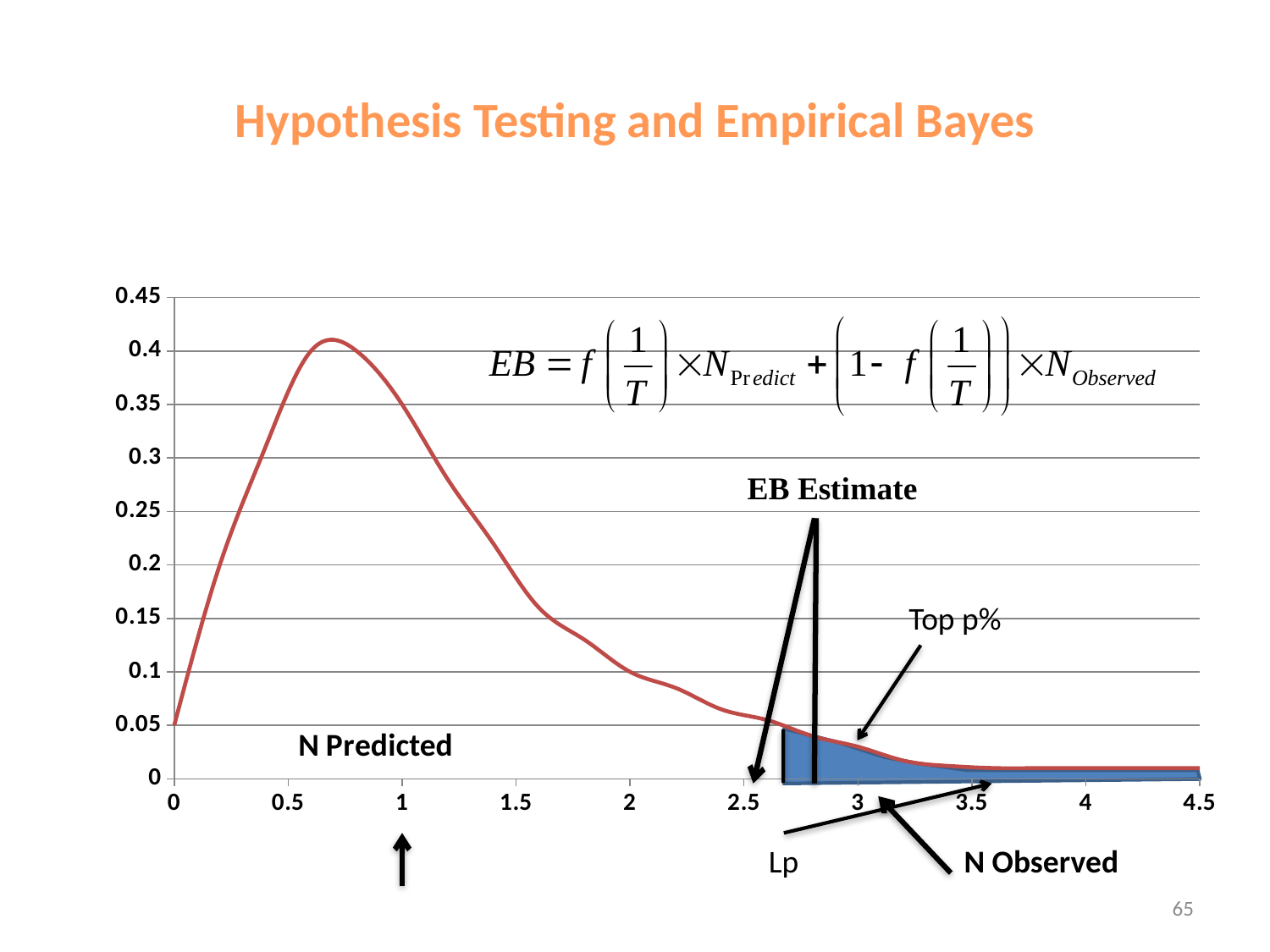
Is the value of the curve at x = 3 greater or less than 0.05? less What kind of chart is shown on the slide? line chart How many data series are plotted on the chart? 1 Is the value of the curve at x = 2 greater or less than 0.15? less Is the value of the curve at x = 1.5 greater or less than 0.15? greater What label is attached to the shaded region under the right tail of the curve? Top p% What is the highest value shown on the y axis? 0.45 Do the values of the curve rise or fall between x = 0 and x = 0.5? rise Do the values of the curve rise or fall between x = 1 and x = 4.5? fall